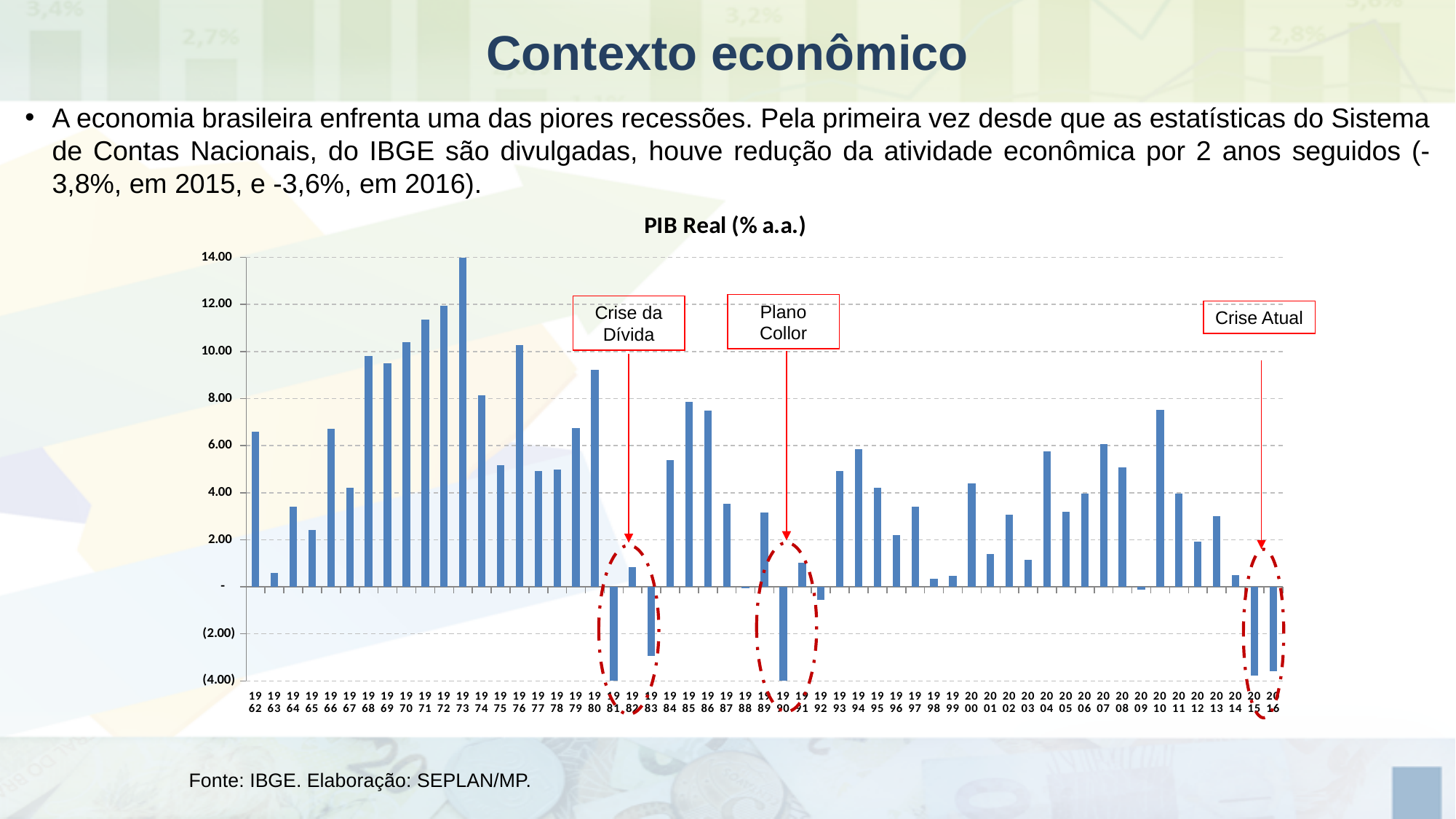
Is the value for 1990 greater or less than (2.00)? less Which year has the larger value, 1973 or 1981? 1973 What kind of chart is shown on the slide? bar chart Is the value for 2015 greater or less than (2.00)? less Is the value for 1965 greater or less than 4.00? less What is the title of the chart? PIB Real (% a.a.) How many years (bars) are plotted in the chart? 55 Which year has the highest value in the chart? 1973 Which annotation label points to the bars for 2015 and 2016? Crise Atual Which year has the larger value, 2010 or 2009? 2010